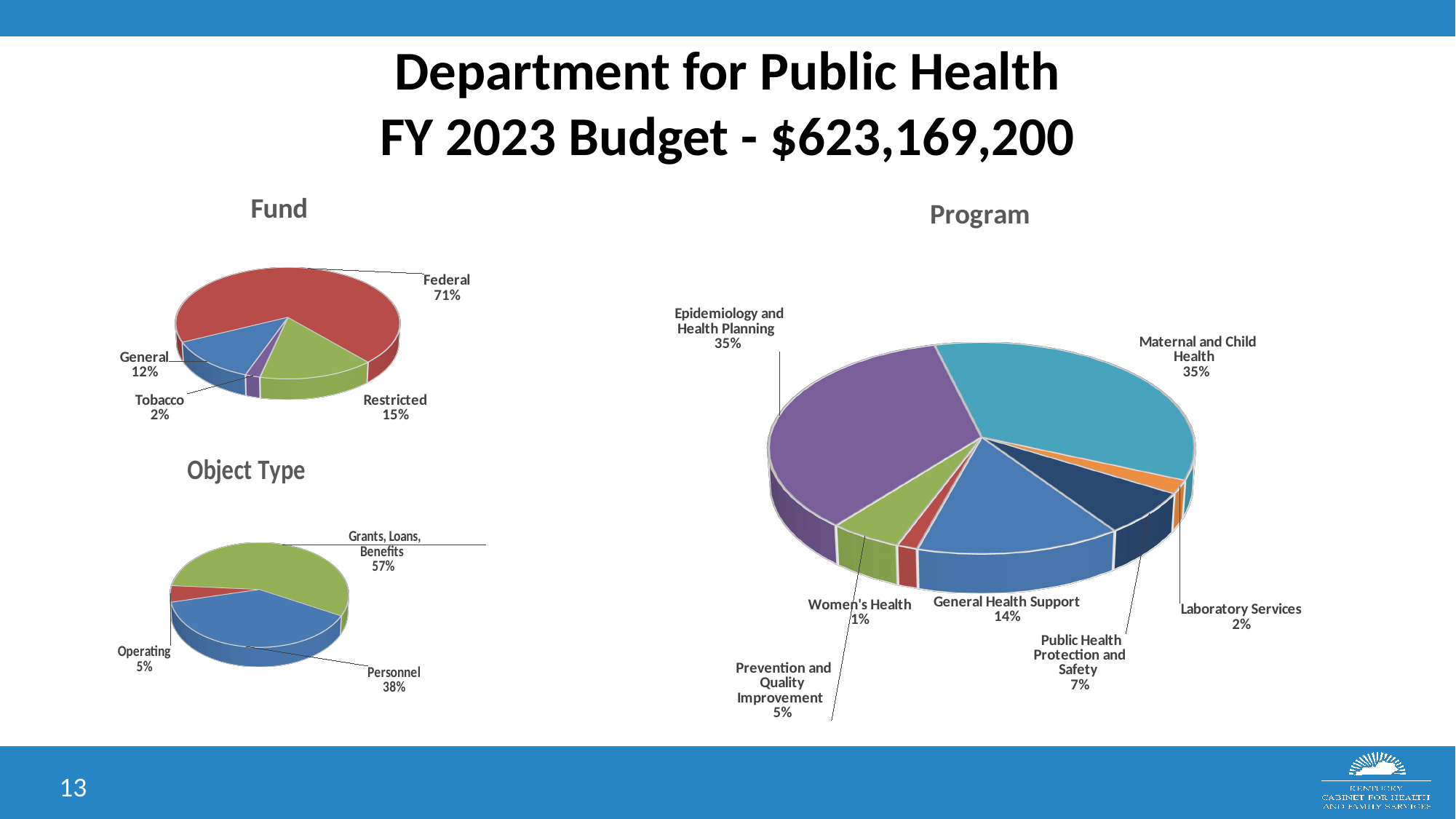
In the Object Type chart, which object type has the largest share? Grants, Loans, Benefits What type of chart is the Program chart? Pie chart In the Program chart, which program has the smallest share? Women's Health In the Fund chart, what share of the budget comes from Federal funds? 71% How many programs are shown in the Program chart? 7 In the Program chart, what share is General Health Support? 14% In the Object Type chart, which is larger, Operating or Personnel? Personnel In the Fund chart, which fund source has the smallest share? Tobacco In the Object Type chart, what share is Personnel? 38% In the Program chart, what is the difference in percentage points between Public Health Protection and Safety and Laboratory Services? 5 In the Fund chart, what is the difference in percentage points between Restricted and General? 3 How many slices does the Fund chart have? 4